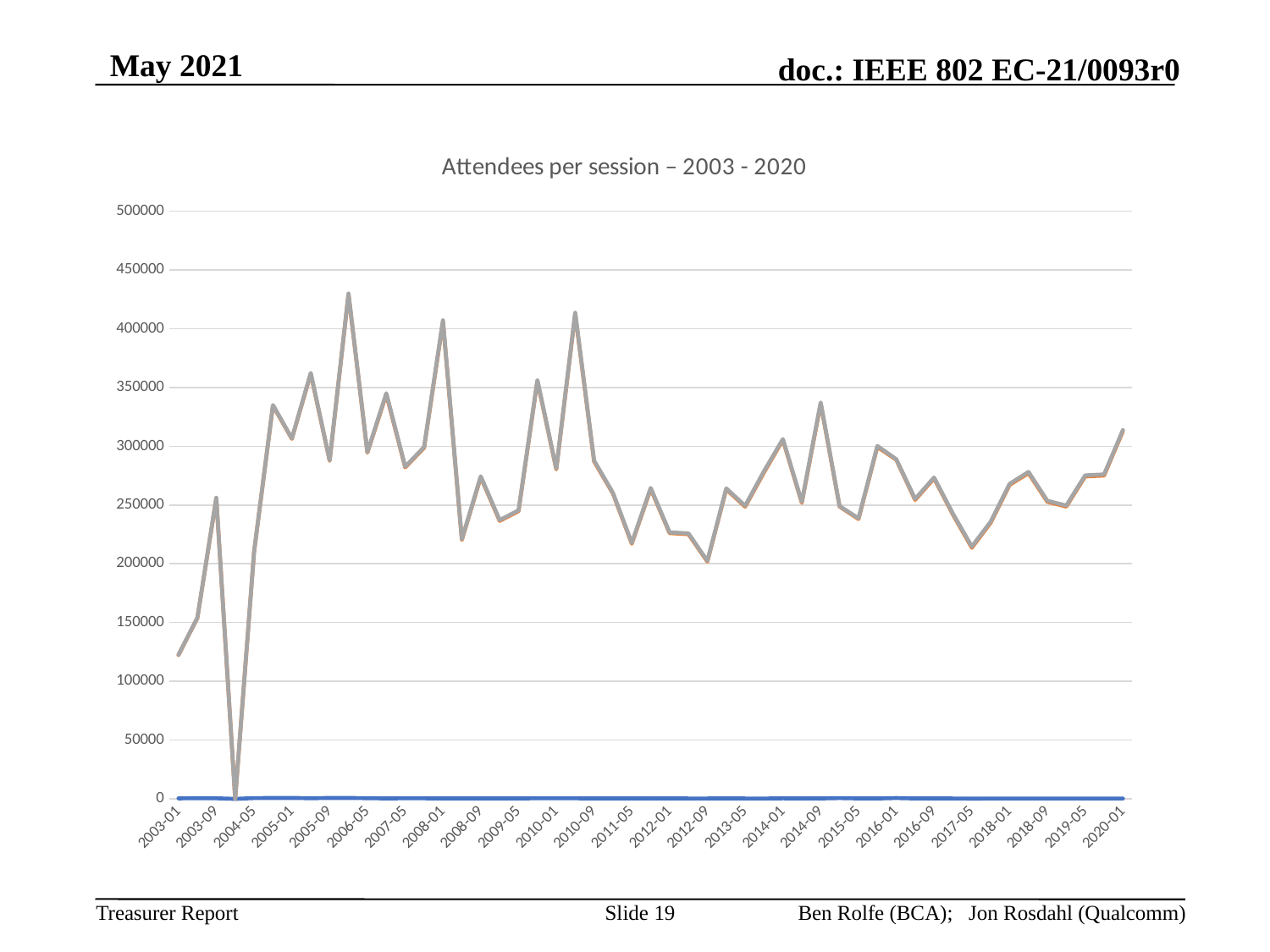
What is the last label on the horizontal axis? 2020-01 Is the highest point on the grey line greater or less than 400000? greater Is the highest point on the grey line greater or less than 450000? less Is the lowest point on the grey line greater or less than 50000? less What kind of chart is shown on the slide? line chart What is the highest tick value shown on the vertical axis? 500000 Which is higher, the value at 2003-01 or the value at 2020-01? 2020-01 What is the title of the chart? Attendees per session – 2003 - 2020